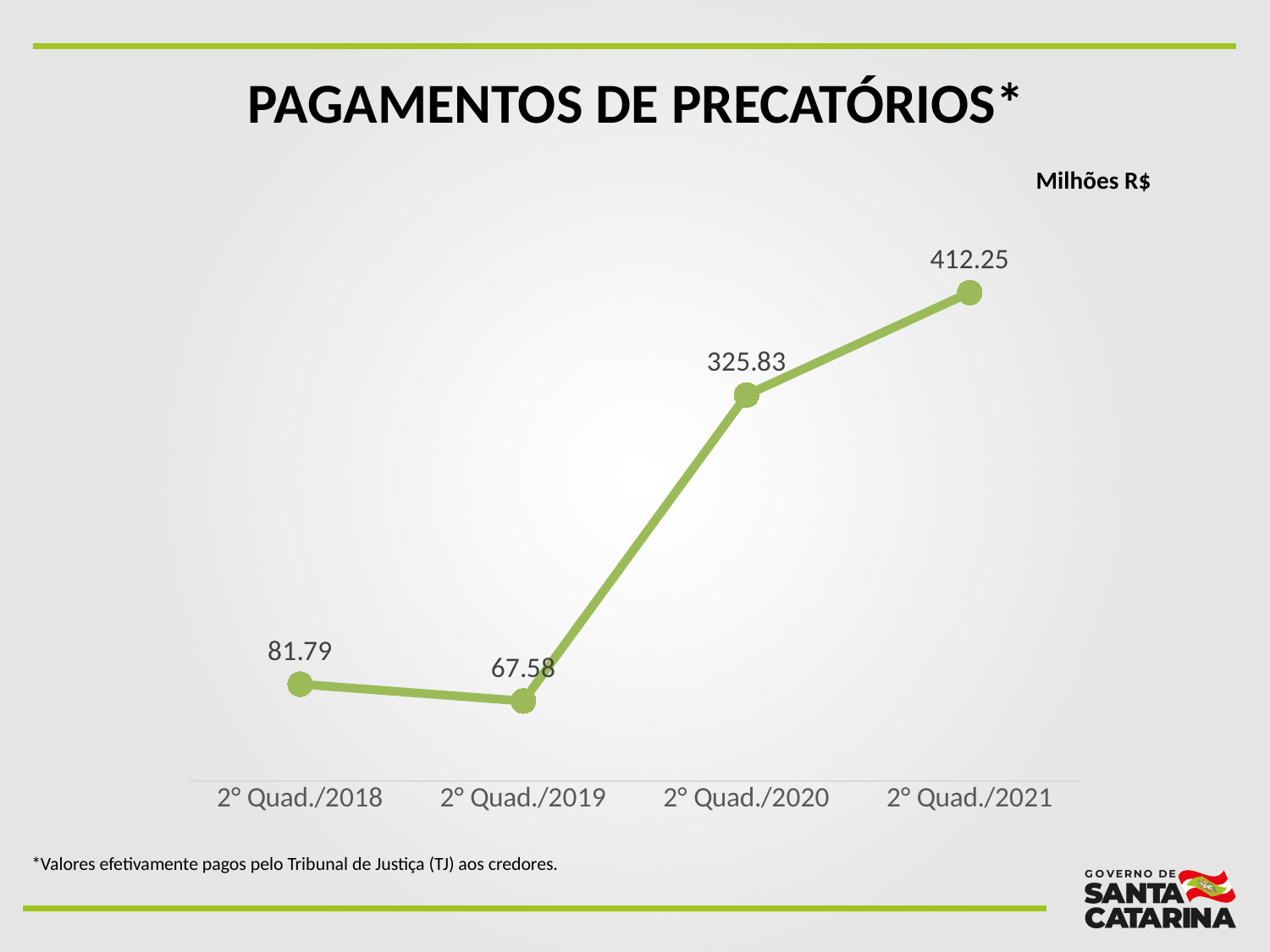
What is the difference between the values for 2° Quad./2018 and 2° Quad./2019? 14.21 What is the value for 2° Quad./2018? 81.79 Which period has the highest value? 2° Quad./2021 What unit is indicated for the values on the chart? Milhões R$ What is the value for 2° Quad./2020? 325.83 What is the difference between the values for 2° Quad./2021 and 2° Quad./2020? 86.42 What is the value for 2° Quad./2019? 67.58 What kind of chart is shown on the slide? Line chart Which is larger, the value for 2° Quad./2020 or the value for 2° Quad./2018? 2° Quad./2020 How many data points are plotted on the chart? 4 What is the value for 2° Quad./2021? 412.25 Which period has the lowest value? 2° Quad./2019